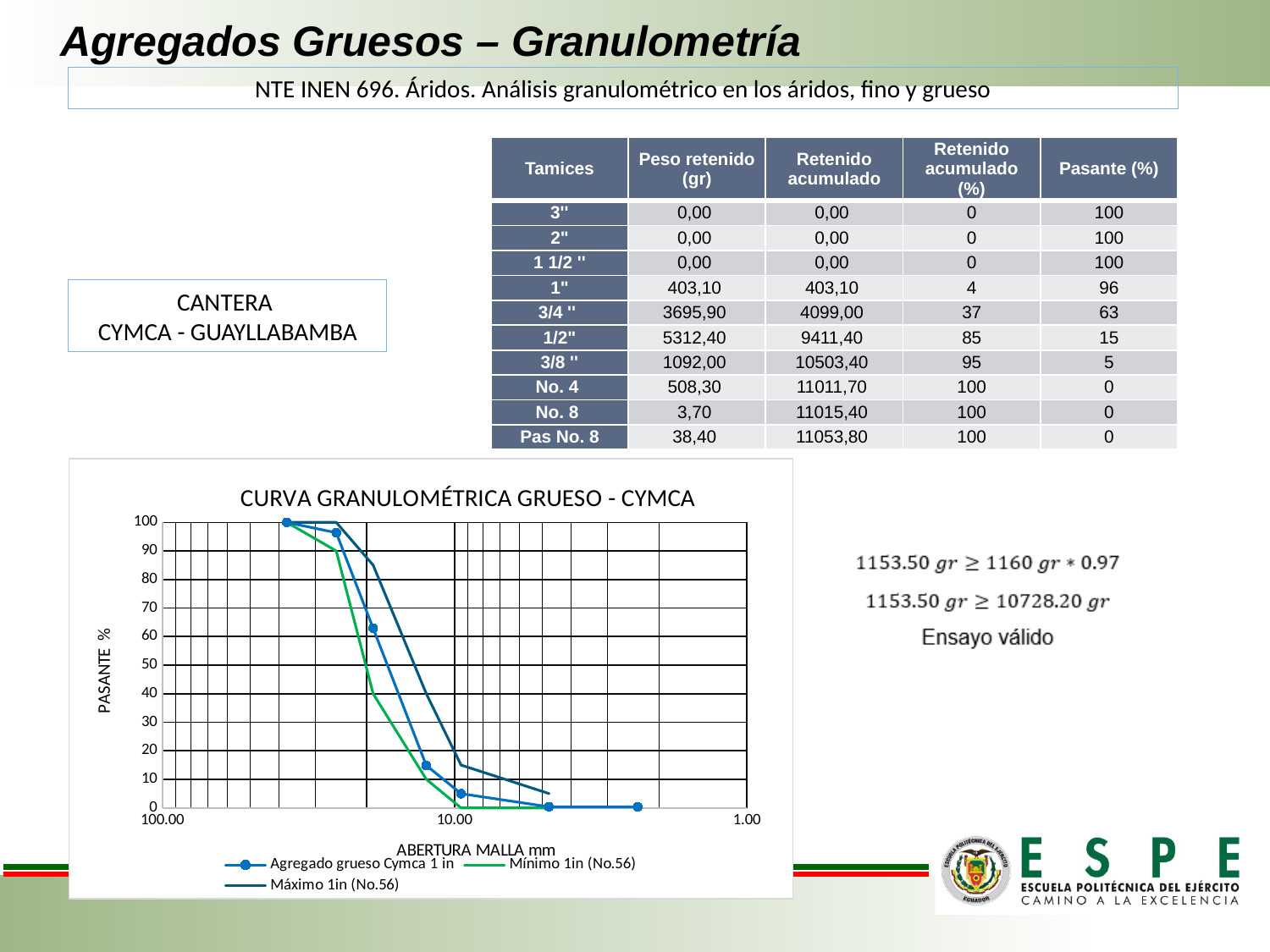
At the 10.00 tick on the x axis, which series is higher, Máximo 1in (No.56) or Mínimo 1in (No.56)? Máximo 1in (No.56) What is the title of the chart? CURVA GRANULOMÉTRICA GRUESO - CYMCA Is the value of the Agregado grueso Cymca 1 in series at its third marker from the left greater or less than 50? greater Is the value of the Agregado grueso Cymca 1 in series at its fourth marker from the left greater or less than 20? less What is the label of the chart's y axis? PASANTE % Do the values of the Agregado grueso Cymca 1 in series rise or fall moving from left to right along the x axis? fall What kind of chart is shown on the slide? line chart How many series does the chart legend list? 3 What is the highest value reached by the Agregado grueso Cymca 1 in series? 100 Is the value of the Máximo 1in (No.56) series at the 10.00 tick on the x axis greater or less than 30? less